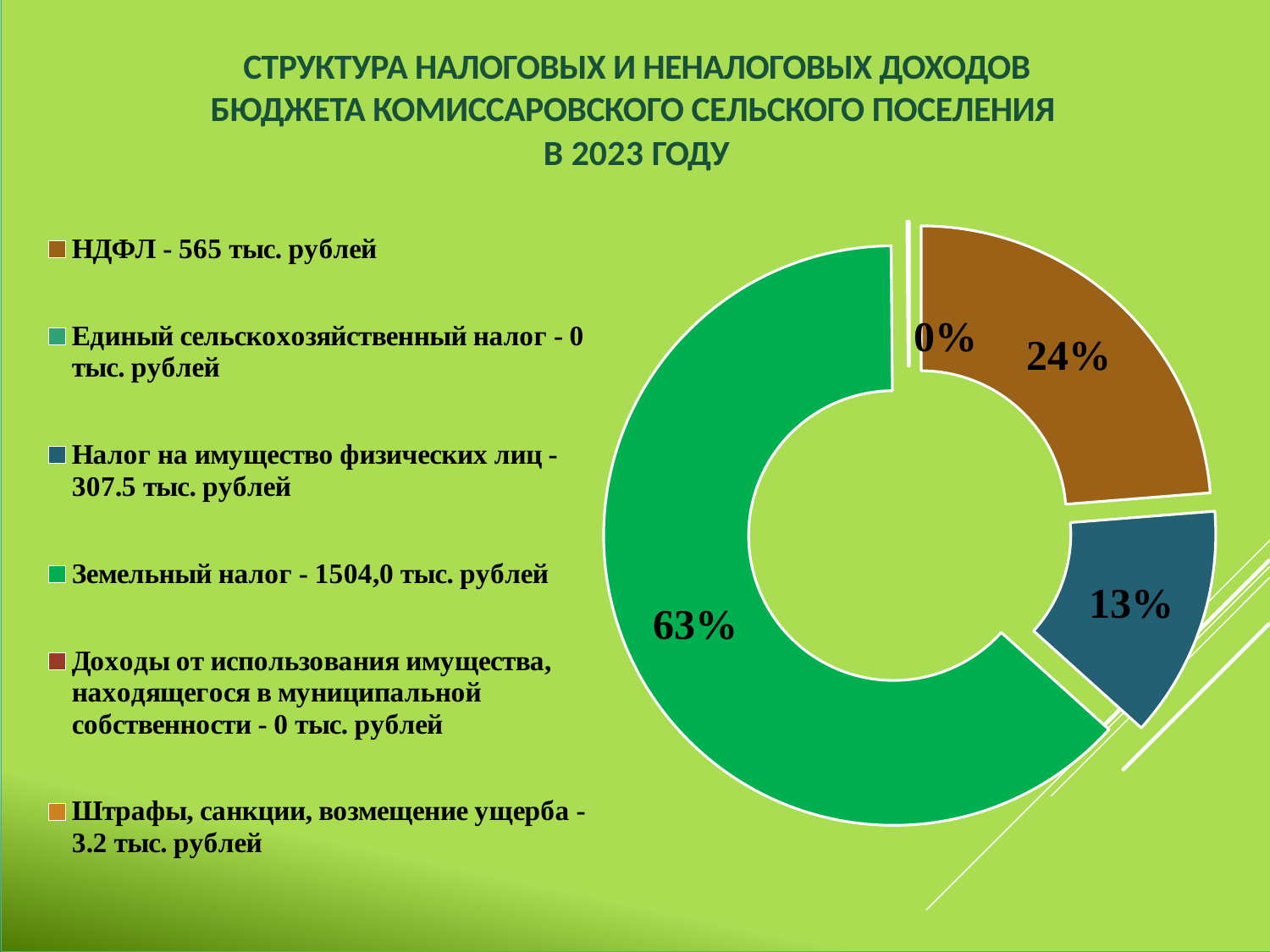
According to the legend, what is the amount for НДФЛ? 565 тыс. рублей How many categories are listed in the chart legend? 6 What share of the chart does Земельный налог account for? 63% What kind of chart is shown on the slide? doughnut (pie) chart Which slice is larger: НДФЛ or Налог на имущество физических лиц? НДФЛ Which category has the largest slice in the chart? Земельный налог What share of the chart does Налог на имущество физических лиц account for? 13% By how many percentage points does the share of НДФЛ exceed the share of Налог на имущество физических лиц? 11 percentage points According to the legend, what is the amount for Земельный налог? 1504,0 тыс. рублей What share of the chart does НДФЛ account for? 24% By how many percentage points does the share of Земельный налог exceed the share of НДФЛ? 39 percentage points What colour is the slice for Земельный налог? green